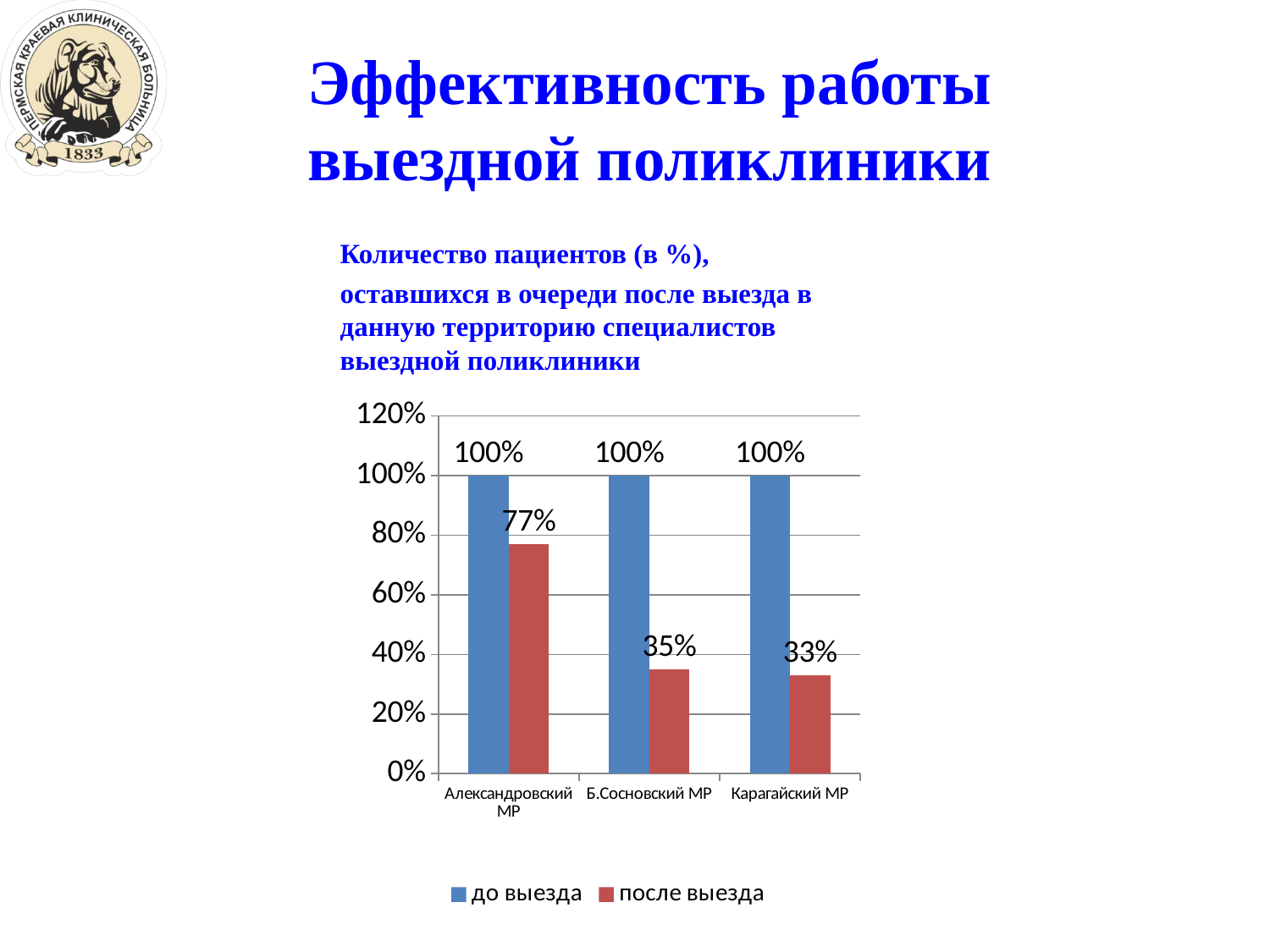
What is the value for "после выезда" in Б.Сосновский МР? 35% Which colour represents the "после выезда" series? Red What is the value for "до выезда" in Карагайский МР? 100% What is the value for "после выезда" in Карагайский МР? 33% What kind of chart is shown on the slide? Bar chart Which category has the lowest value for "после выезда"? Карагайский МР How many series does the legend list? 2 Which is larger: the "после выезда" value for Александровский МР or for Б.Сосновский МР? Александровский МР Which category has the highest value for "после выезда"? Александровский МР How many categories are shown on the x axis? 3 What is the value for "после выезда" in Александровский МР? 77% What is the difference between the "до выезда" and "после выезда" values for Б.Сосновский МР? 65%